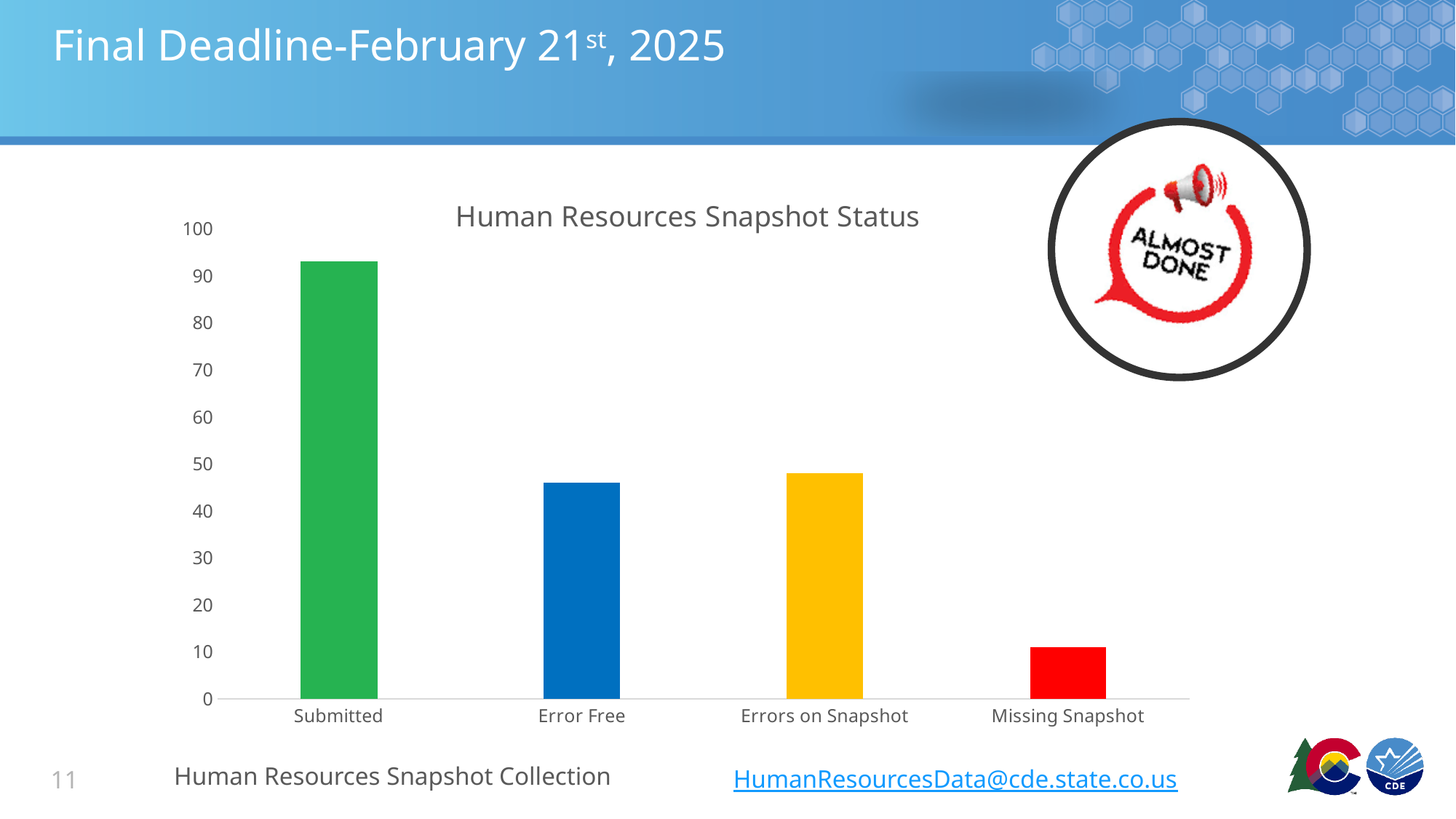
What colour is the bar for Missing Snapshot? red Which category has the highest value in the chart? Submitted Is the value for Errors on Snapshot greater or less than 40? greater Which is larger, the value for Submitted or the value for Missing Snapshot? Submitted How many categories are shown on the x axis of the chart? 4 Is the value for Submitted greater or less than 90? greater What is the title of the chart? Human Resources Snapshot Status Is the value for Error Free greater or less than 50? less Which is larger, the value for Error Free or the value for Submitted? Submitted What type of chart is shown on the slide? bar chart Which category has the lowest value in the chart? Missing Snapshot